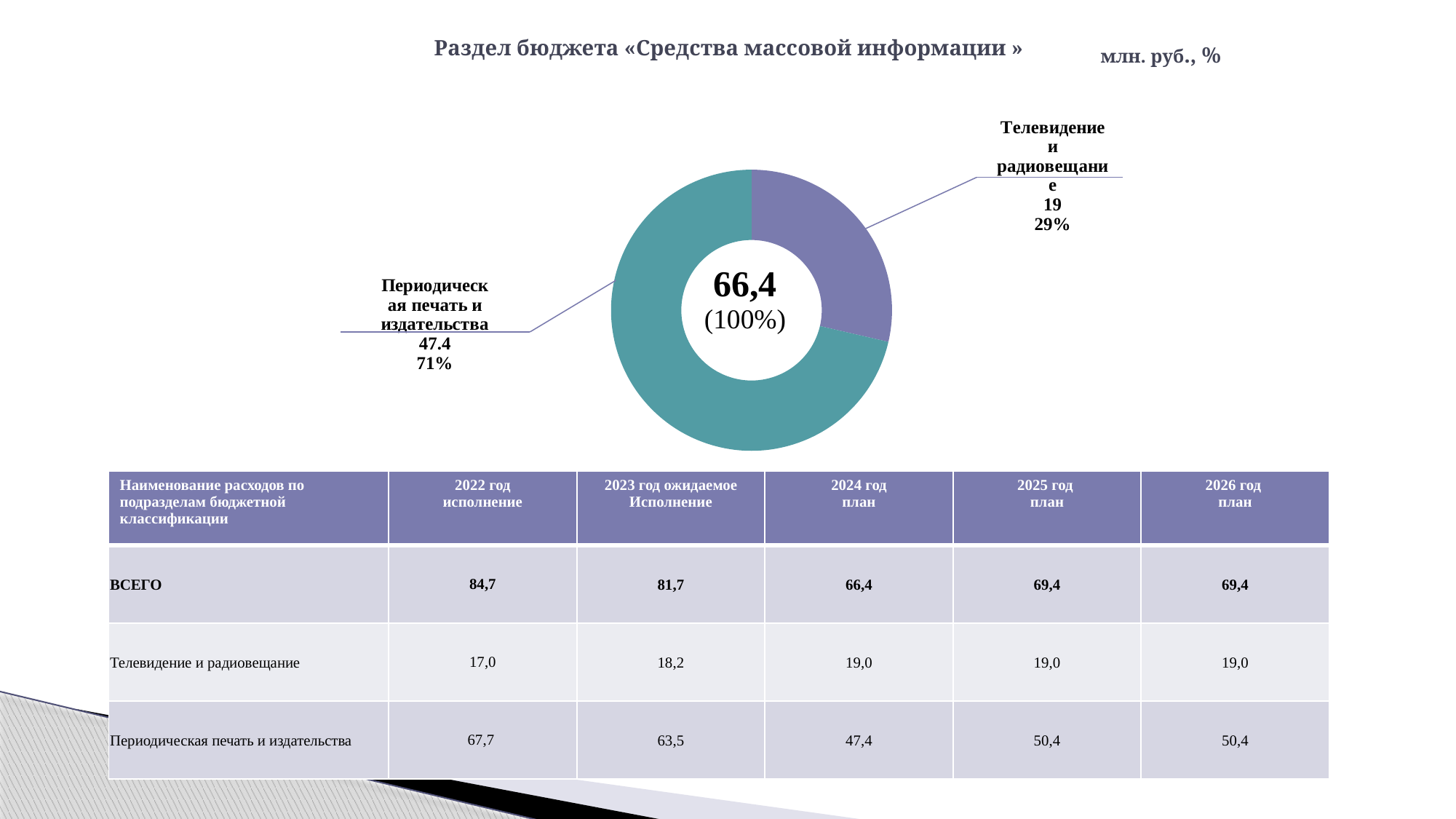
What value is shown for «Телевидение и радиовещание» in the doughnut chart? 19 Which slice of the doughnut chart is the largest? Периодическая печать и издательства What kind of chart is shown on the slide? Pie (doughnut) chart What is the difference between the values for «Периодическая печать и издательства» and «Телевидение и радиовещание» in the doughnut chart? 28.4 Which is larger in the doughnut chart: «Телевидение и радиовещание» or «Периодическая печать и издательства»? Периодическая печать и издательства How many slices does the doughnut chart have? 2 What share of the doughnut chart does «Периодическая печать и издательства» take? 71% Which slice of the doughnut chart is the smallest? Телевидение и радиовещание What total value is printed in the centre of the doughnut chart? 66,4 What share of the doughnut chart does «Телевидение и радиовещание» take? 29% What is the title of the slide containing the doughnut chart? Раздел бюджета «Средства массовой информации » What value is shown for «Периодическая печать и издательства» in the doughnut chart? 47.4